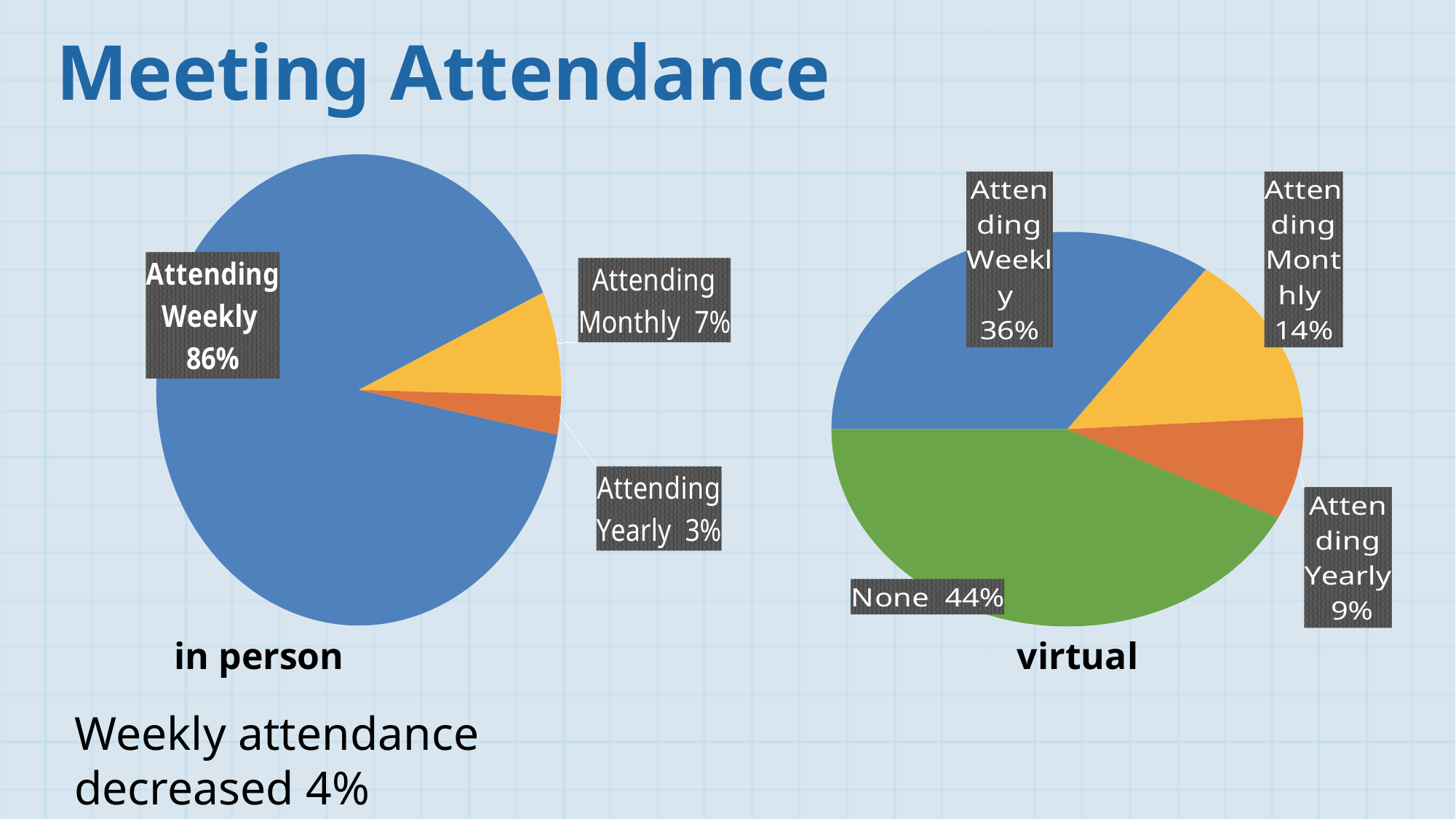
In the "in person" pie chart, what share is labelled for Attending Yearly? 3% In the "virtual" pie chart, what share is labelled for Attending Yearly? 9% In the "virtual" pie chart, what share is labelled for None? 44% In the "in person" pie chart, which category has the smallest slice? Attending Yearly In the "virtual" pie chart, which category has the largest slice? None In the "virtual" pie chart, which category has the smallest slice? Attending Yearly What is the difference between the Attending Weekly share in the "in person" chart and the Attending Weekly share in the "virtual" chart? 50% How many slices does the "virtual" pie chart have? 4 What type of chart is used for the "in person" data? Pie chart